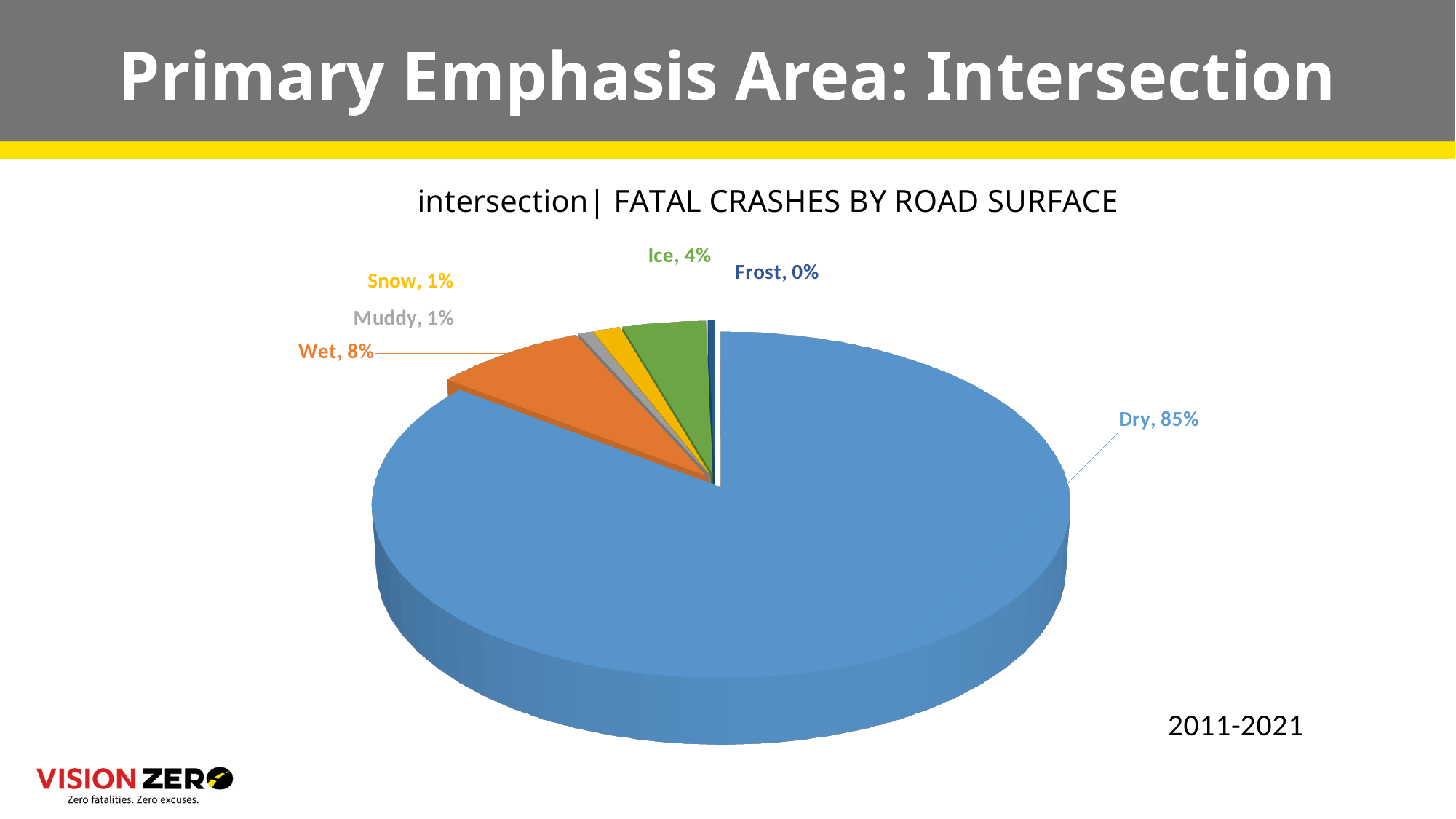
What is the title of the chart? intersection| FATAL CRASHES BY ROAD SURFACE What year range does the chart cover? 2011-2021 Which road surface category has the smallest share of fatal crashes? Frost How many percentage points larger is the Dry share than the Wet share? 77 What share of intersection fatal crashes occurred on a wet road surface? 8% How many road surface categories are shown in the pie chart? 6 Which has a larger share, Wet or Ice? Wet What kind of chart is shown on the slide? Pie chart What percentage is shown for Frost? 0% What percentage is shown for Ice? 4% What share of intersection fatal crashes occurred on a dry road surface? 85% Which road surface category has the largest share of fatal crashes? Dry